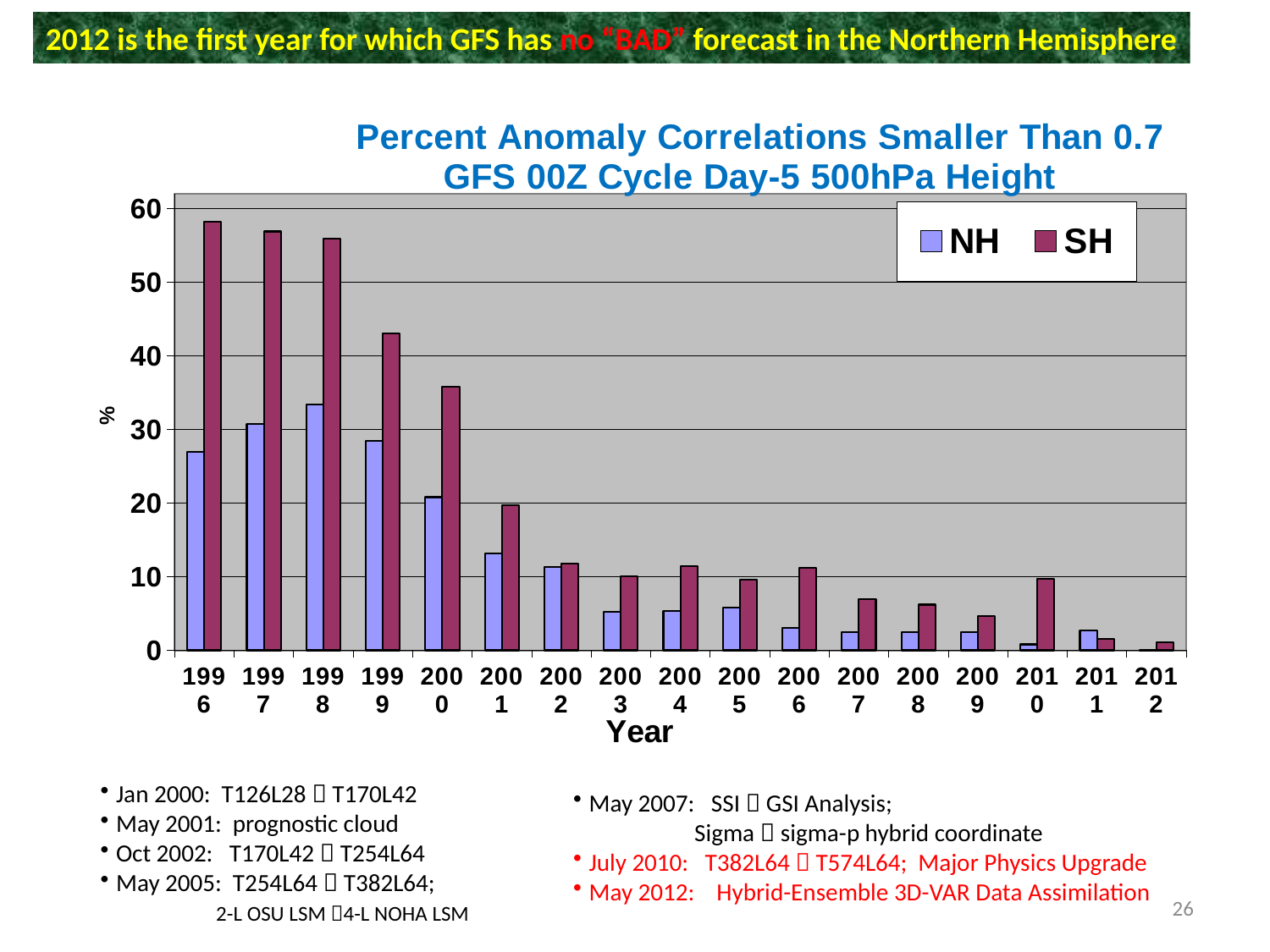
Do the NH values generally rise or fall from 1996 to 2012? fall Is the SH value for 1996 greater or less than 50? greater Is the NH value for 2006 greater or less than 10? less Is the NH value for 1996 greater or less than 30? less Which series has the larger value in 1996, NH or SH? SH What are the two entries in the chart legend? NH and SH Which series has the larger value in 2010, NH or SH? SH How many series does the chart legend list? 2 What kind of chart is shown on the slide? bar chart How many years are shown along the x axis of the chart? 17 In which year is the NH value lowest? 2012